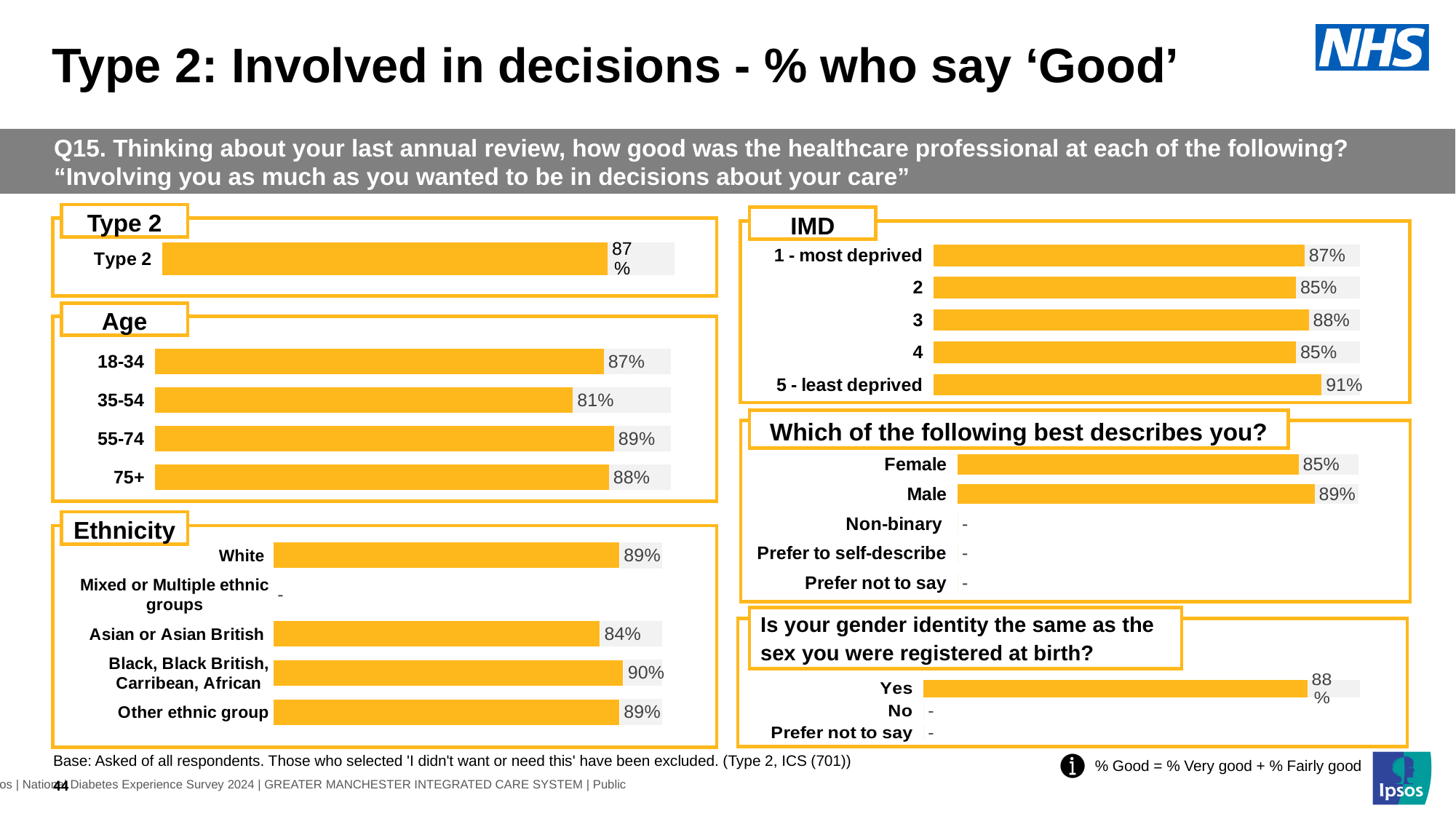
In the 'Which of the following best describes you?' chart, which is larger, Female or Male? Male In the IMD chart, what is the value for 5 - least deprived? 91% In the Age chart, which age group has the highest value? 55-74 In the IMD chart, what is the difference between 5 - least deprived and 2? 6 percentage points In the Age chart, what is the value for 35-54? 81% In the Ethnicity chart, which group has the highest value? Black, Black British, Carribean, African In the Age chart, which age group has the lowest value? 35-54 In the Ethnicity chart, what is the value for Asian or Asian British? 84% In the 'Which of the following best describes you?' chart, what is the difference between Male and Female? 4 percentage points What kind of chart is the Age chart? Bar chart In the 'Is your gender identity the same as the sex you were registered at birth?' chart, what is the value for Yes? 88% In the IMD chart, which category has the highest value? 5 - least deprived